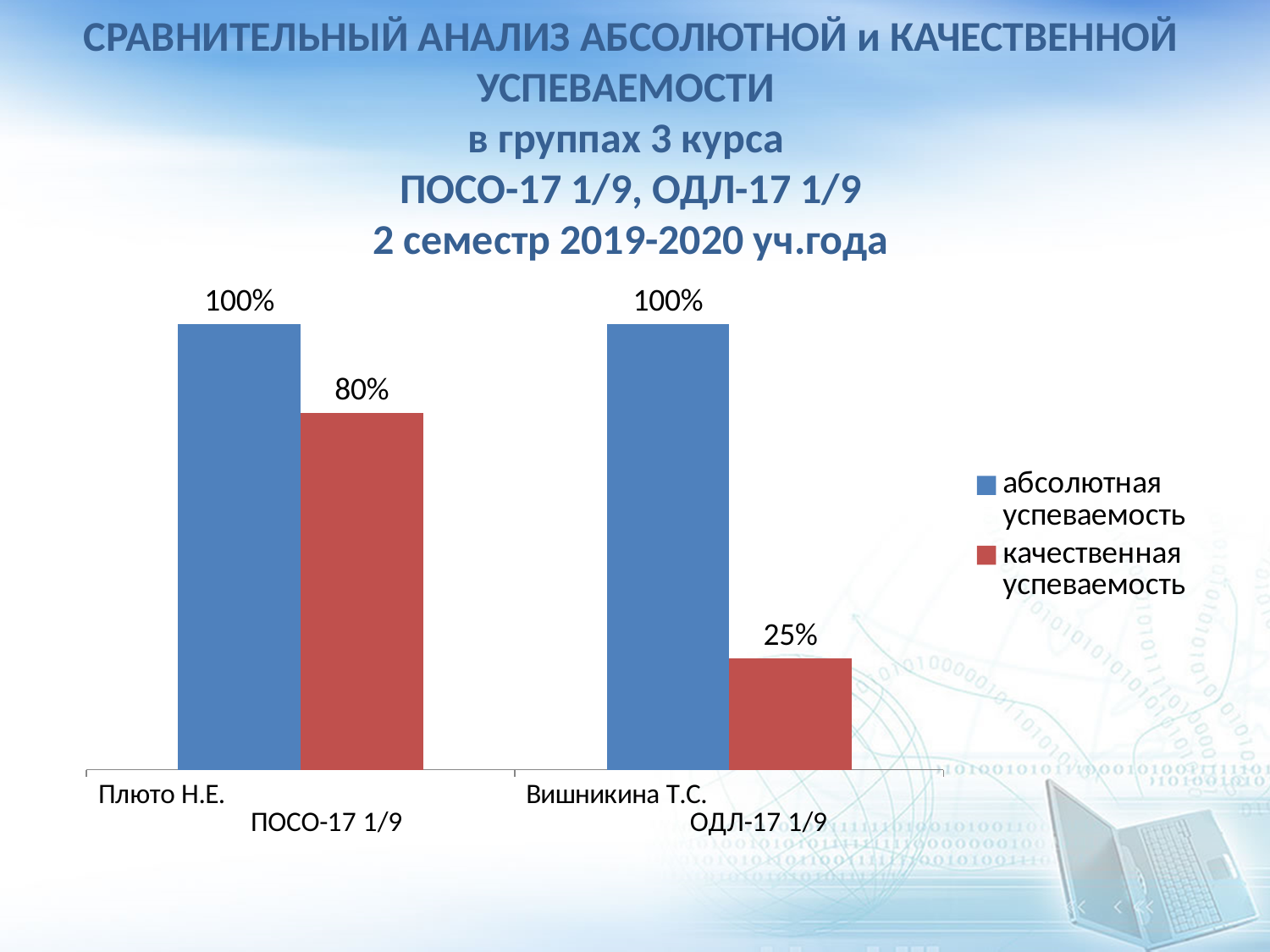
What is the difference in качественная успеваемость between ПОСО-17 1/9 and ОДЛ-17 1/9? 55% What is the абсолютная успеваемость value for ПОСО-17 1/9? 100% What is the качественная успеваемость value for ОДЛ-17 1/9 (Вишникина Т.С.)? 25% How many groups (categories) are shown on the chart? 2 Which group has the lowest качественная успеваемость? ОДЛ-17 1/9 What kind of chart is shown on the slide? bar chart For ОДЛ-17 1/9, what is the difference between абсолютная and качественная успеваемость? 75% What is the абсолютная успеваемость value for ОДЛ-17 1/9? 100% Which group has the higher качественная успеваемость? ПОСО-17 1/9 How many series does the legend list? 2 Is the качественная успеваемость for ОДЛ-17 1/9 larger or smaller than that for ПОСО-17 1/9? smaller What is the качественная успеваемость value for ПОСО-17 1/9 (Плюто Н.Е.)? 80%